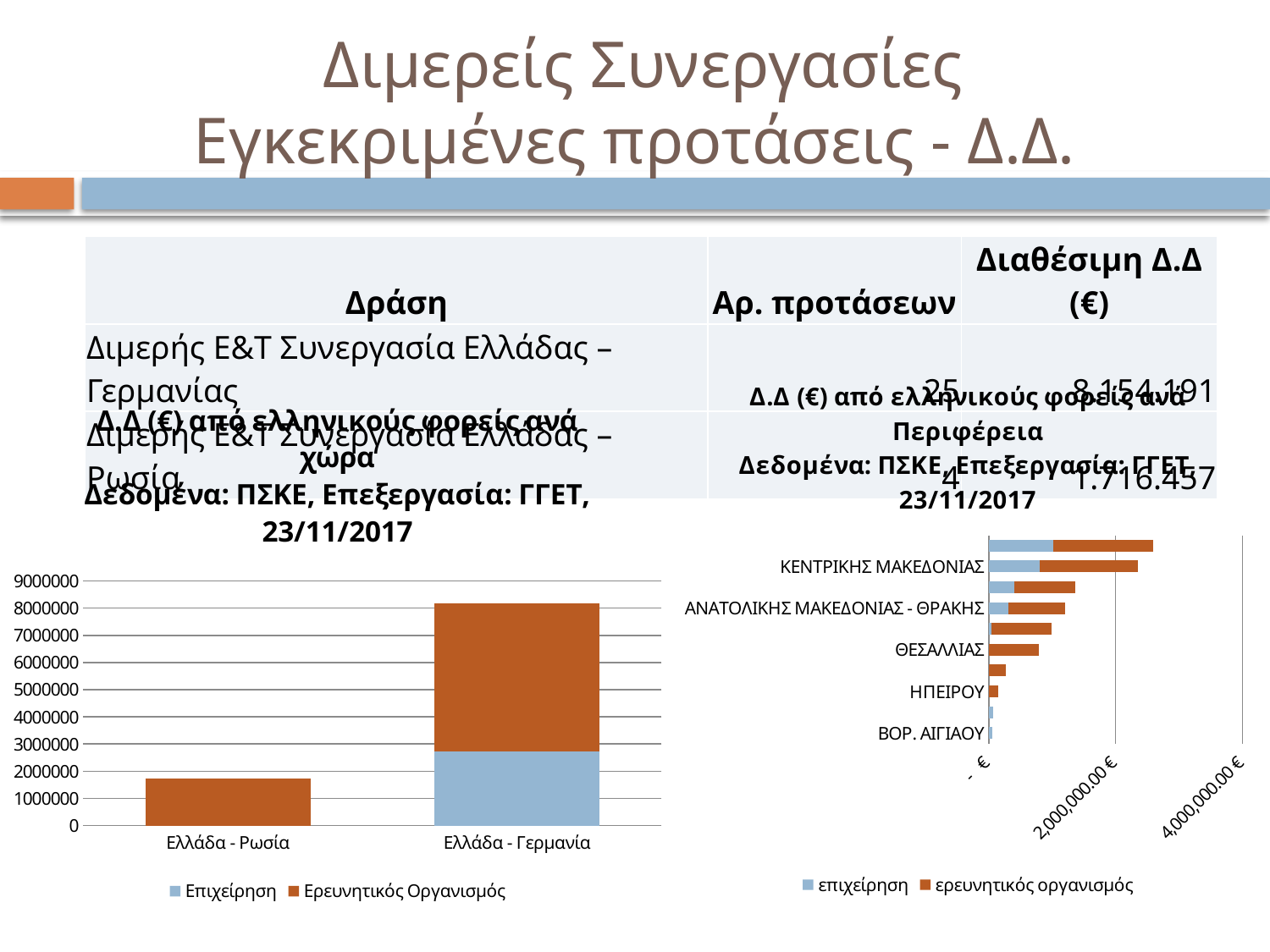
How many series does the legend of the left chart (Δ.Δ (€) από ελληνικούς φορείς ανά χώρα) list? 2 In the left chart (Δ.Δ (€) από ελληνικούς φορείς ανά χώρα), is the total bar for Ελλάδα - Ρωσία greater or less than 2000000? less In the left chart (Δ.Δ (€) από ελληνικούς φορείς ανά χώρα), which category has the taller stacked bar? Ελλάδα - Γερμανία In the right chart (Δ.Δ (€) από ελληνικούς φορείς ανά Περιφέρεια), which has the longer bar, ΘΕΣΣΑΛΙΑΣ or ΗΠΕΙΡΟΥ? ΘΕΣΑΛΛΙΑΣ In the right chart (Δ.Δ (€) από ελληνικούς φορείς ανά Περιφέρεια), which has the longer bar, ΚΕΝΤΡΙΚΗΣ ΜΑΚΕΔΟΝΙΑΣ or ΑΝΑΤΟΛΙΚΗΣ ΜΑΚΕΔΟΝΙΑΣ - ΘΡΑΚΗΣ? ΚΕΝΤΡΙΚΗΣ ΜΑΚΕΔΟΝΙΑΣ How many series does the legend of the right chart (Δ.Δ (€) από ελληνικούς φορείς ανά Περιφέρεια) list? 2 In the left chart (Δ.Δ (€) από ελληνικούς φορείς ανά χώρα), is the total bar for Ελλάδα - Γερμανία greater or less than 7000000? greater In the right chart (Δ.Δ (€) από ελληνικούς φορείς ανά Περιφέρεια), is the bar for ΒΟΡ. ΑΙΓΙΑΟΥ greater or less than 2,000,000.00 €? less What kind of chart is the chart titled "Δ.Δ (€) από ελληνικούς φορείς ανά Περιφέρεια" on the right of the slide? Stacked bar chart In the left chart (Δ.Δ (€) από ελληνικούς φορείς ανά χώρα), which series is shown in orange? Ερευνητικός Οργανισμός What kind of chart is the chart titled "Δ.Δ (€) από ελληνικούς φορείς ανά χώρα" on the left of the slide? Stacked bar chart In the left chart (Δ.Δ (€) από ελληνικούς φορείς ανά χώρα), how many categories are shown on the x axis? 2